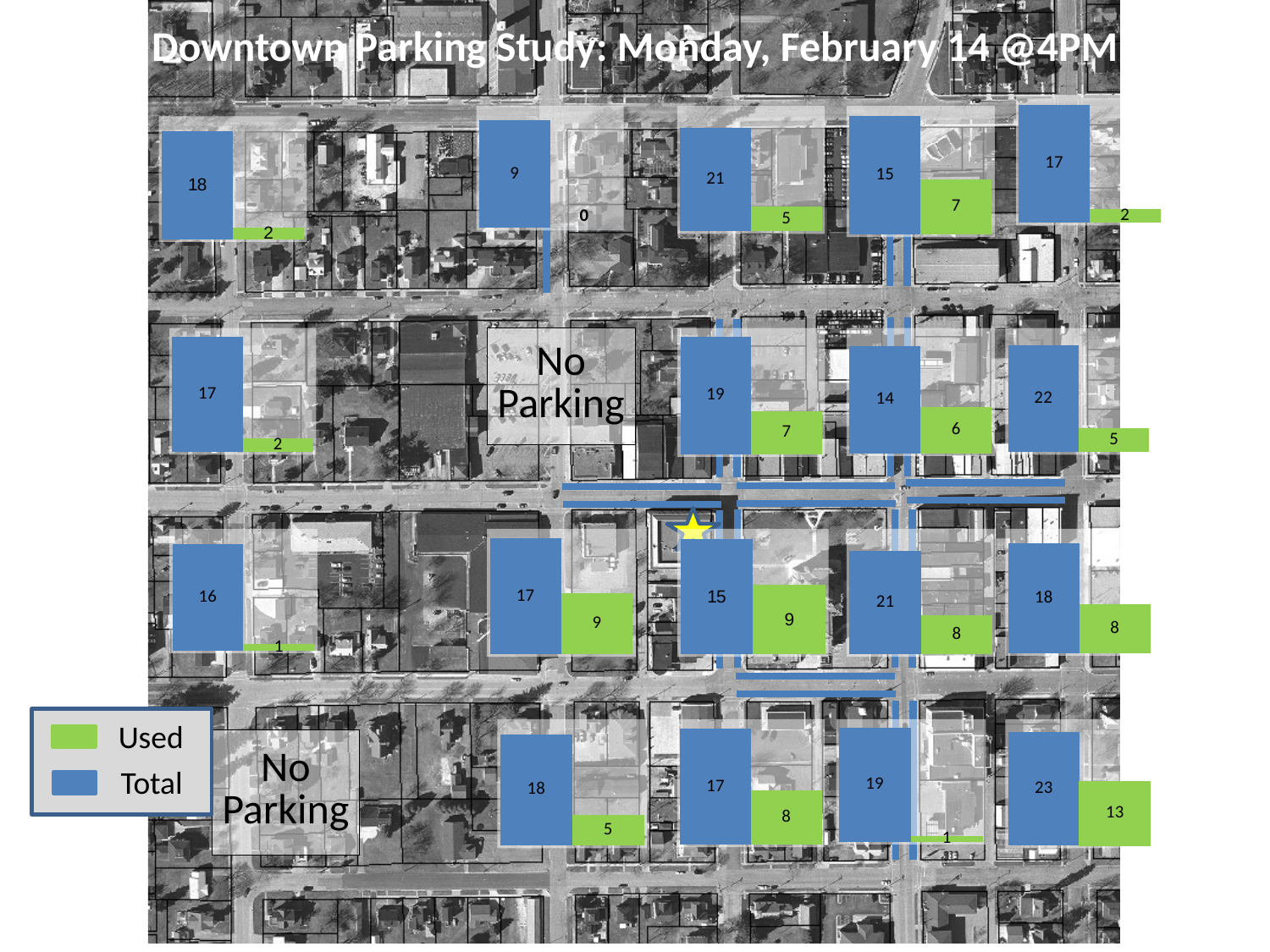
What kind of chart is used for each block on the map? Bar chart In the chart at the top-left corner of the map, what is the Used value? 2 In the chart at the bottom-right corner of the map, which is larger, Total or Used? Total How many series does the legend list? 2 Across all the block charts on the map, what is the lowest Used value shown? 0 Across all the block charts on the map, what is the highest Total value shown? 23 In the chart at the top-left corner of the map, what is the Total value? 18 In the chart at the bottom-right corner of the map, what is the Used value? 13 Which colour represents the Used series in the legend? Green What is the title of the slide's chart display? Downtown Parking Study: Monday, February 14 @4PM In the chart at the bottom-right corner of the map, what is the difference between Total and Used? 10 In the chart at the bottom-right corner of the map, what is the Total value? 23